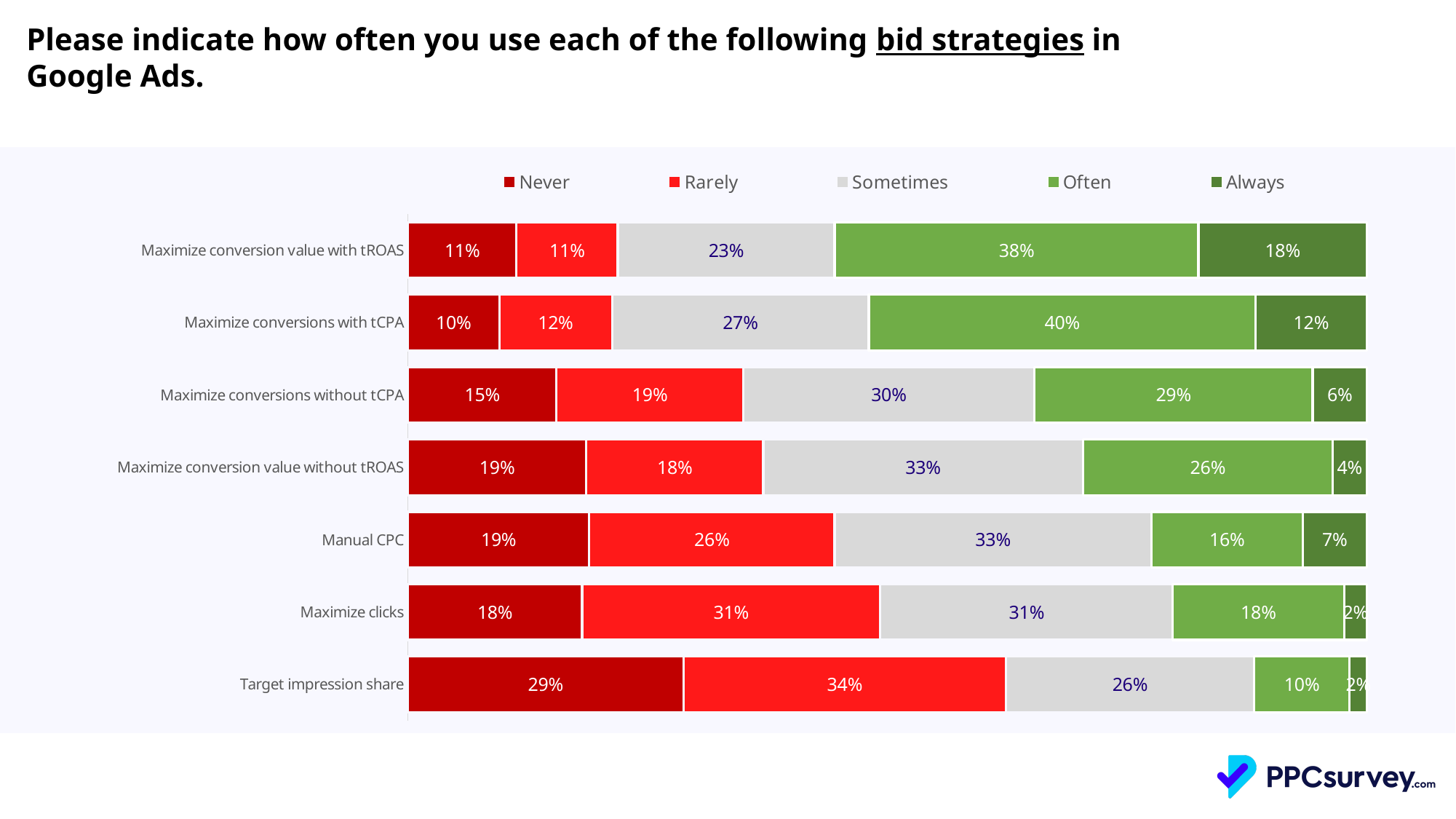
What is the difference between the 'Rarely' values for Target impression share and Maximize conversion value with tROAS? 23% How many bid strategies are shown in the chart? 7 Which bid strategy has the highest 'Never' percentage? Target impression share What is the 'Sometimes' value for Manual CPC? 33% Which is larger: the 'Often' value for Maximize conversions without tCPA or the 'Often' value for Manual CPC? Maximize conversions without tCPA What percentage of respondents say they 'Often' use Maximize conversions with tCPA? 40% Which bid strategy has the lowest 'Often' percentage? Target impression share What is the 'Always' value for Maximize conversion value with tROAS? 18% How many series does the legend list? 5 What type of chart is shown on the slide? Stacked bar chart What percentage of respondents 'Never' use Target impression share? 29% Which bid strategy has the highest 'Always' percentage? Maximize conversion value with tROAS